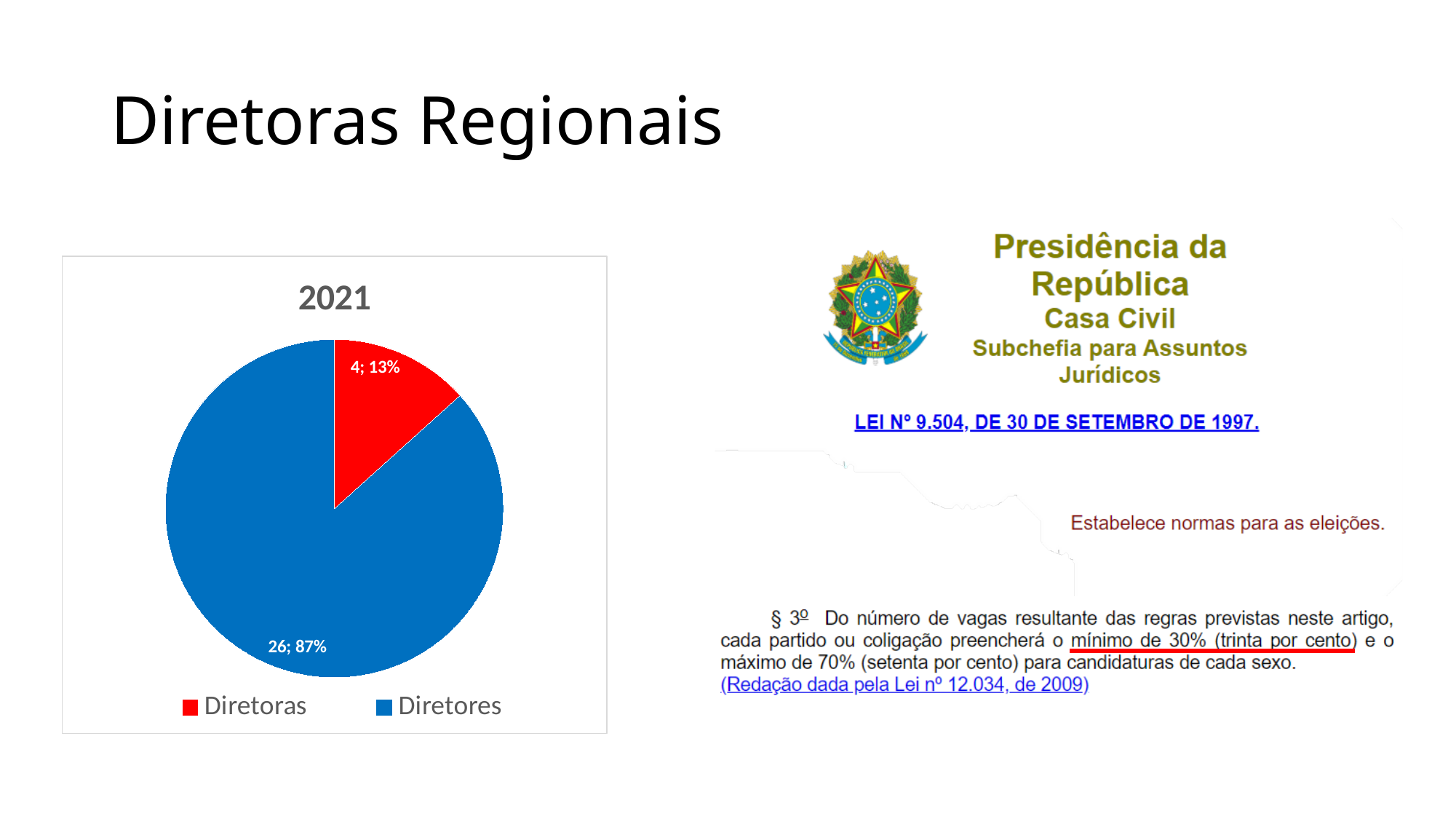
What is the value for Diretoras in the pie chart? 4 How many slices does the pie chart have? 2 How many entries does the legend of the pie chart list? 2 What is the difference between the values for Diretores and Diretoras? 22 Which colour represents Diretoras in the pie chart? red What is the value for Diretores in the pie chart? 26 Which slice of the pie chart is the largest? Diretores Which slice of the pie chart is the smallest? Diretoras What share of the pie does the Diretoras slice represent? 13% What is the title of the pie chart? 2021 What share of the pie does the Diretores slice represent? 87% What kind of chart is shown on the slide? pie chart